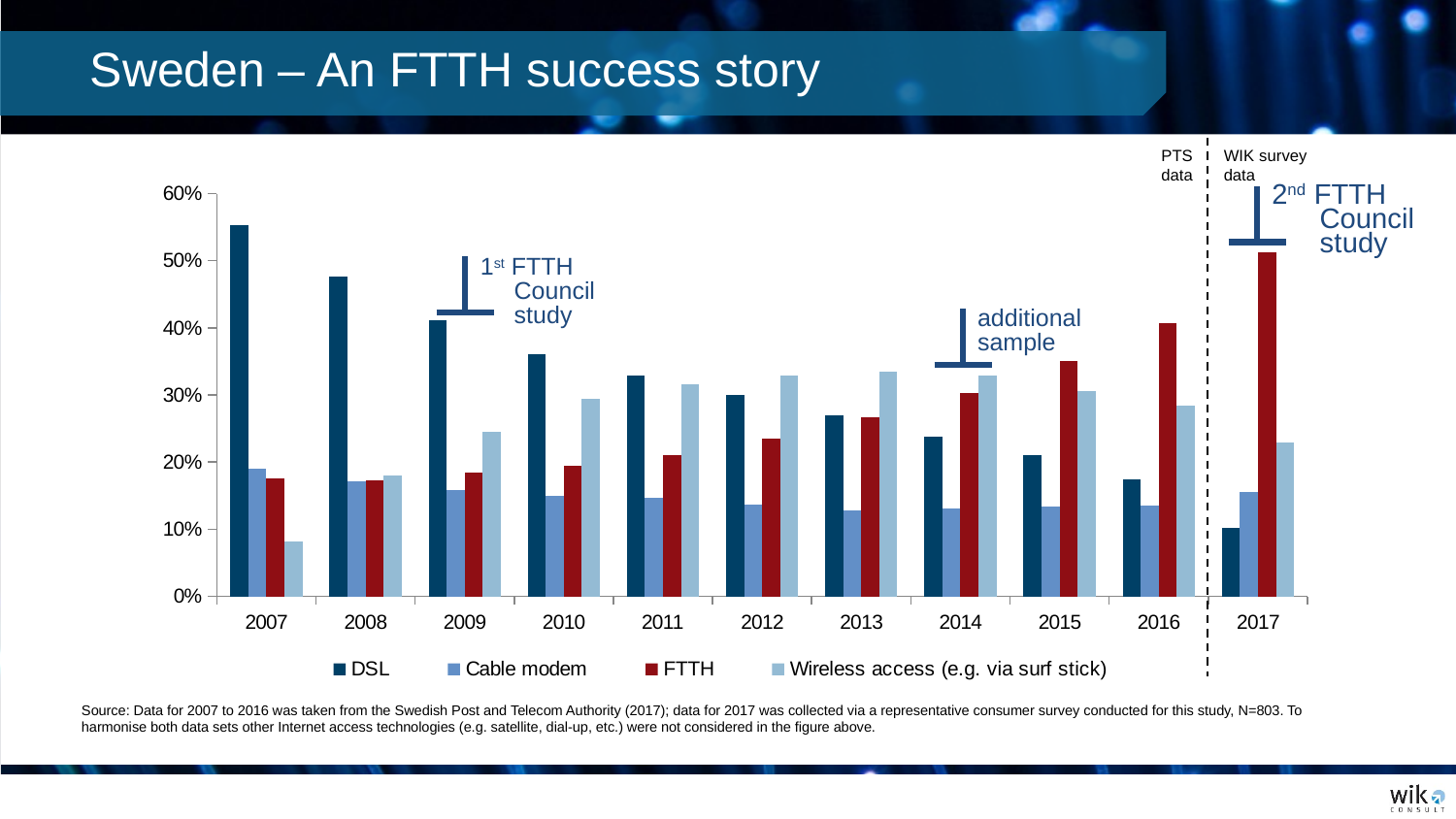
What kind of chart is shown on the slide? bar chart Is the DSL value for 2007 greater or less than 50%? greater In which year is the DSL share lowest? 2017 Does the DSL share rise or fall from 2007 to 2017? fall Is the Wireless access value for 2007 greater or less than 10%? less Which series is shown in dark red in the legend? FTTH Does the FTTH share rise or fall from 2007 to 2017? rise In which year is the DSL share highest? 2007 In which year is the FTTH share highest? 2017 How many years are shown on the x axis? 11 In 2016, which is larger: the FTTH share or the DSL share? FTTH How many series does the legend list? 4